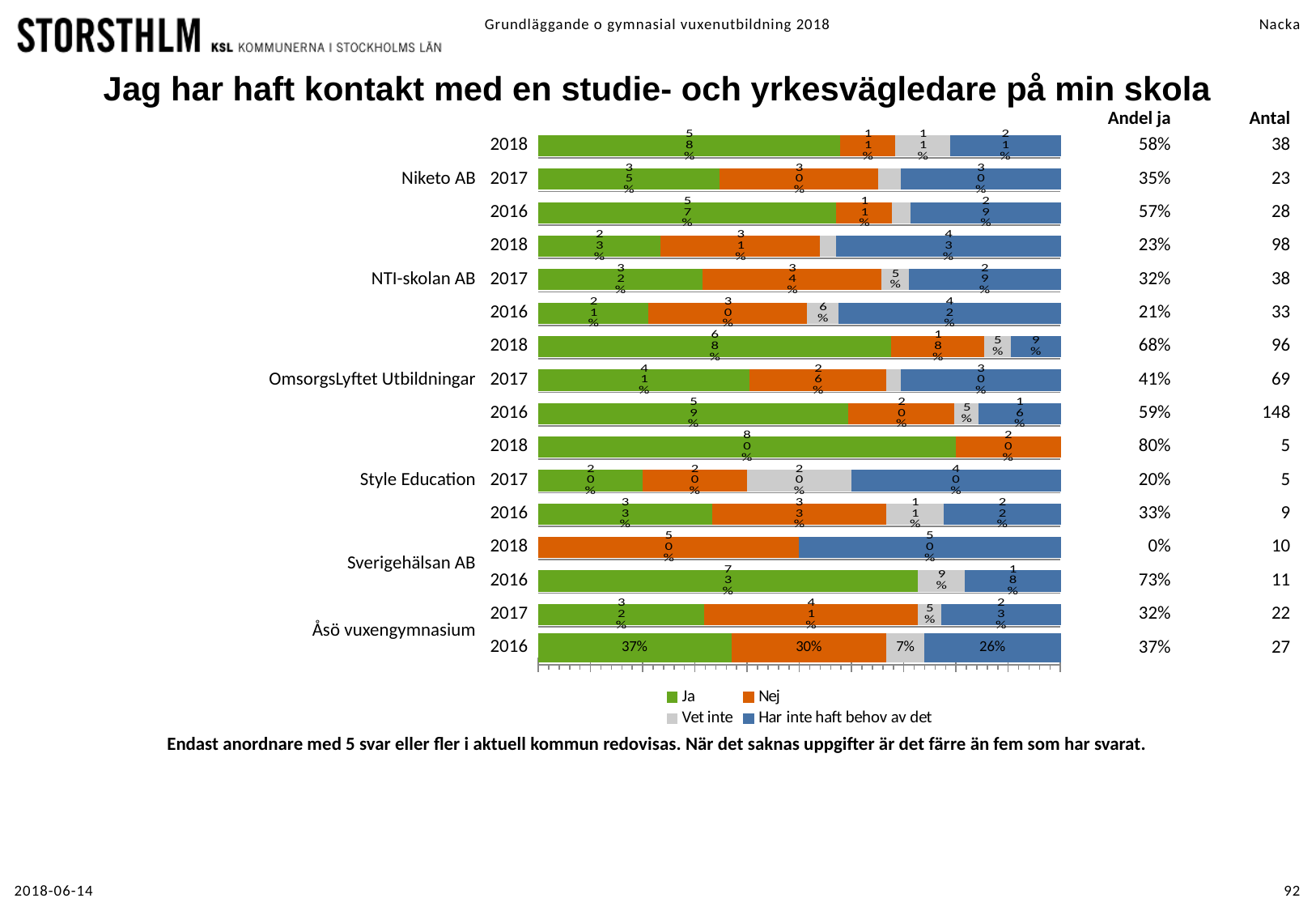
What is the 'Ja' share for Åsö vuxengymnasium in 2016? 37% For OmsorgsLyftet Utbildningar, which year has the larger 'Ja' share, 2018 or 2016? 2018 What is the 'Nej' share for Åsö vuxengymnasium in 2016? 30% What kind of chart is shown on the slide? Stacked bar chart Which bar has the highest 'Ja' share? Style Education 2018 What is the 'Har inte haft behov av det' share for Åsö vuxengymnasium in 2016? 26% By how many percentage points does the 'Ja' share for Niketo AB in 2018 exceed that in 2017? 23 percentage points Which bar has the lowest 'Ja' share? Sverigehälsan AB 2018 What are the four legend entries of the chart? Ja, Nej, Vet inte, Har inte haft behov av det What is the 'Ja' share for Style Education in 2018? 80% How many series does the legend list? 4 How many bars are plotted in the chart? 16